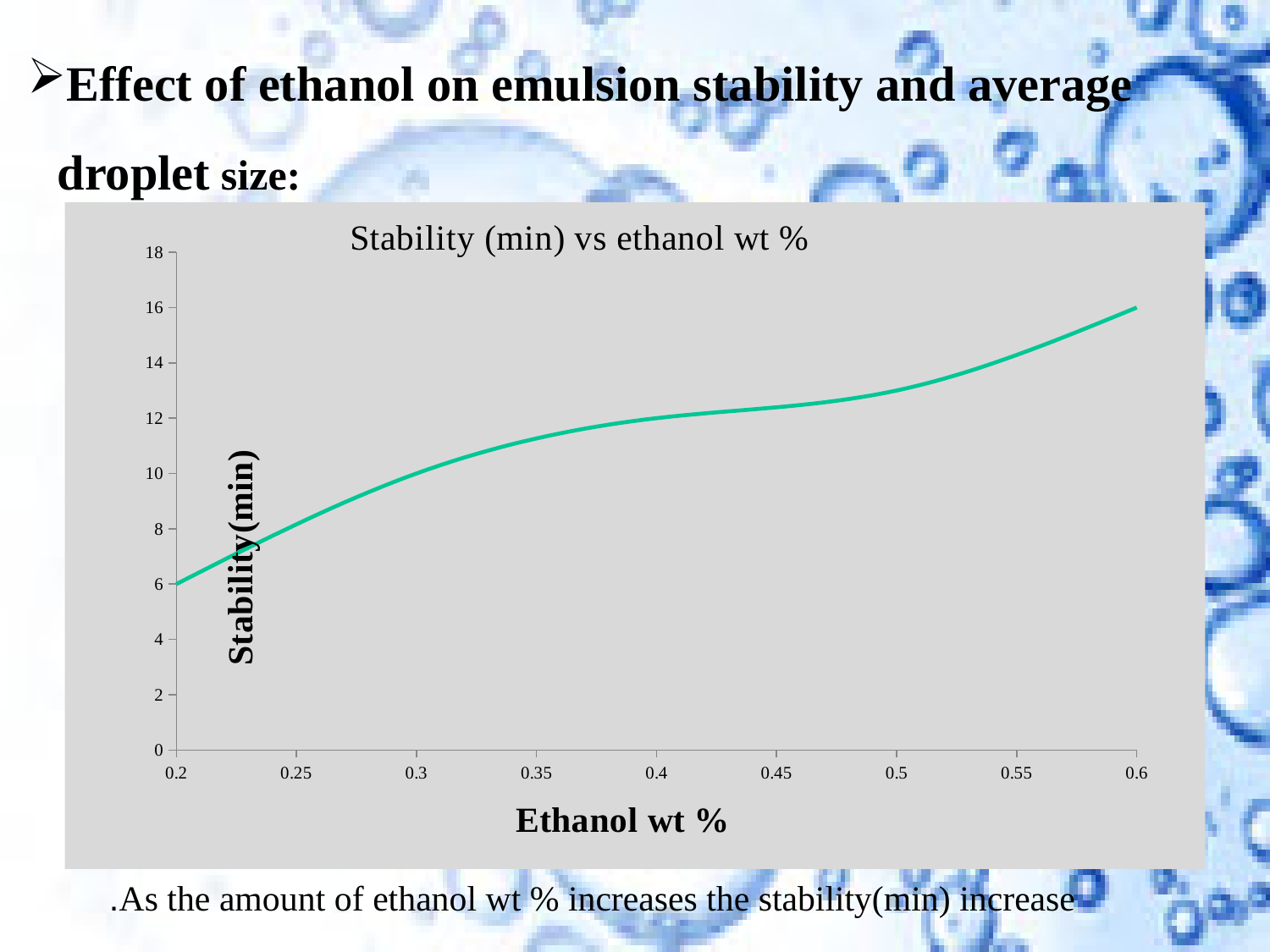
Is the stability at 0.25 ethanol wt % greater or less than 10? less How many tick values are labelled on the x axis? 9 Do the stability values rise or fall as ethanol wt % increases along the x axis? rise Which has the larger stability, 0.3 ethanol wt % or 0.5 ethanol wt %? 0.5 Is the stability at 0.5 ethanol wt % greater or less than 12? greater Is the stability at 0.35 ethanol wt % greater or less than 10? greater What kind of chart is shown on the slide? line chart What is the title of the chart? Stability (min) vs ethanol wt % At which ethanol wt % is the stability lowest? 0.2 What is the label of the x axis? Ethanol wt % At which ethanol wt % is the stability highest? 0.6